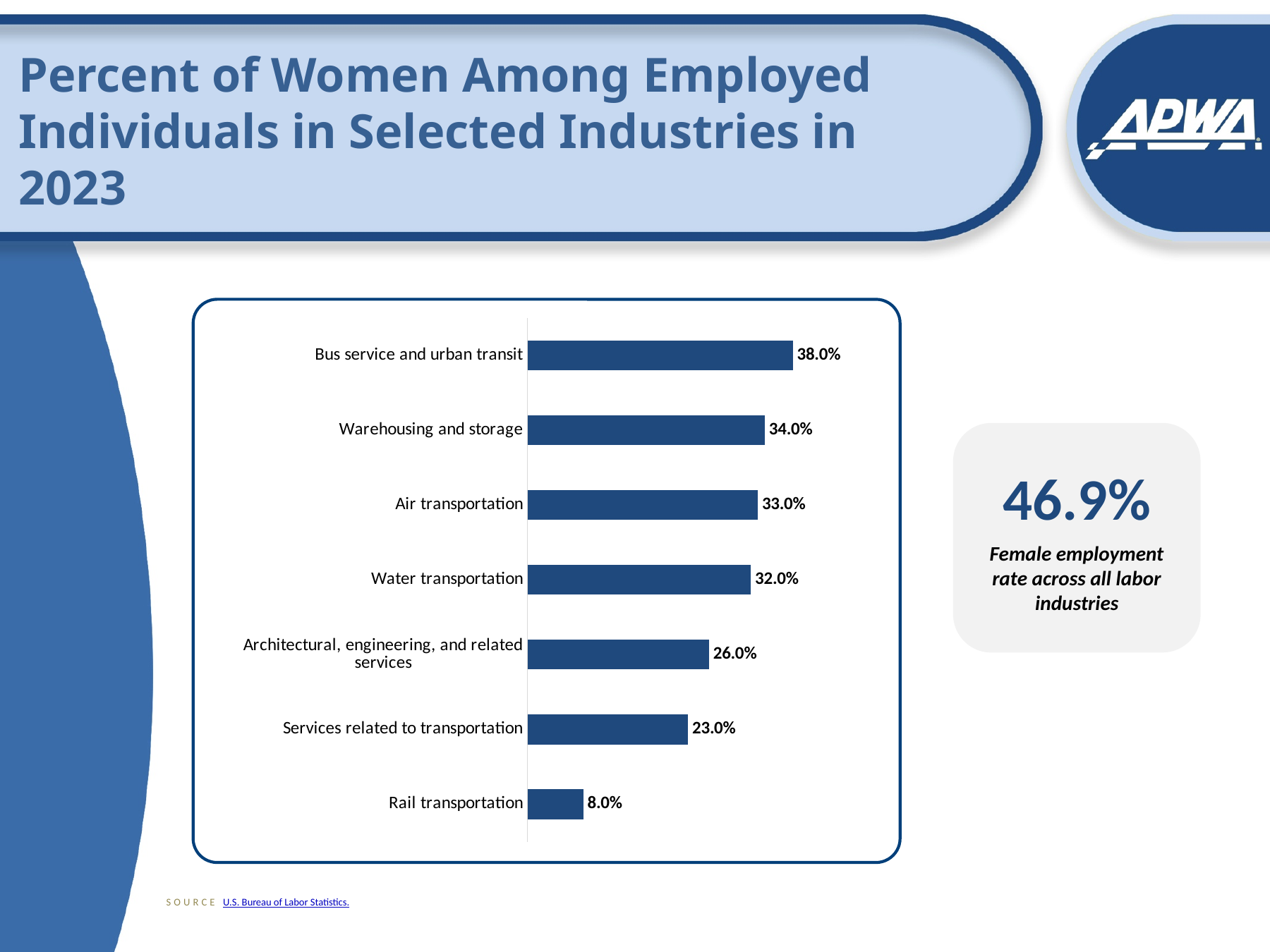
What is the percent of women among employed individuals in Bus service and urban transit? 38.0% Which has a larger value, Services related to transportation or Architectural, engineering, and related services? Architectural, engineering, and related services Which has a larger value, Air transportation or Water transportation? Air transportation What is the value shown for Rail transportation? 8.0% What is the difference between the values for Warehousing and storage and Services related to transportation? 11.0% Which industry has the highest percent of women among employed individuals? Bus service and urban transit What is the difference between the values for Bus service and urban transit and Rail transportation? 30.0% Which industry has the lowest percent of women among employed individuals? Rail transportation What kind of chart is shown on the slide? Bar chart What female employment rate across all labor industries is shown on the slide? 46.9% How many industries are shown in the chart? 7 What is the value shown for Architectural, engineering, and related services? 26.0%